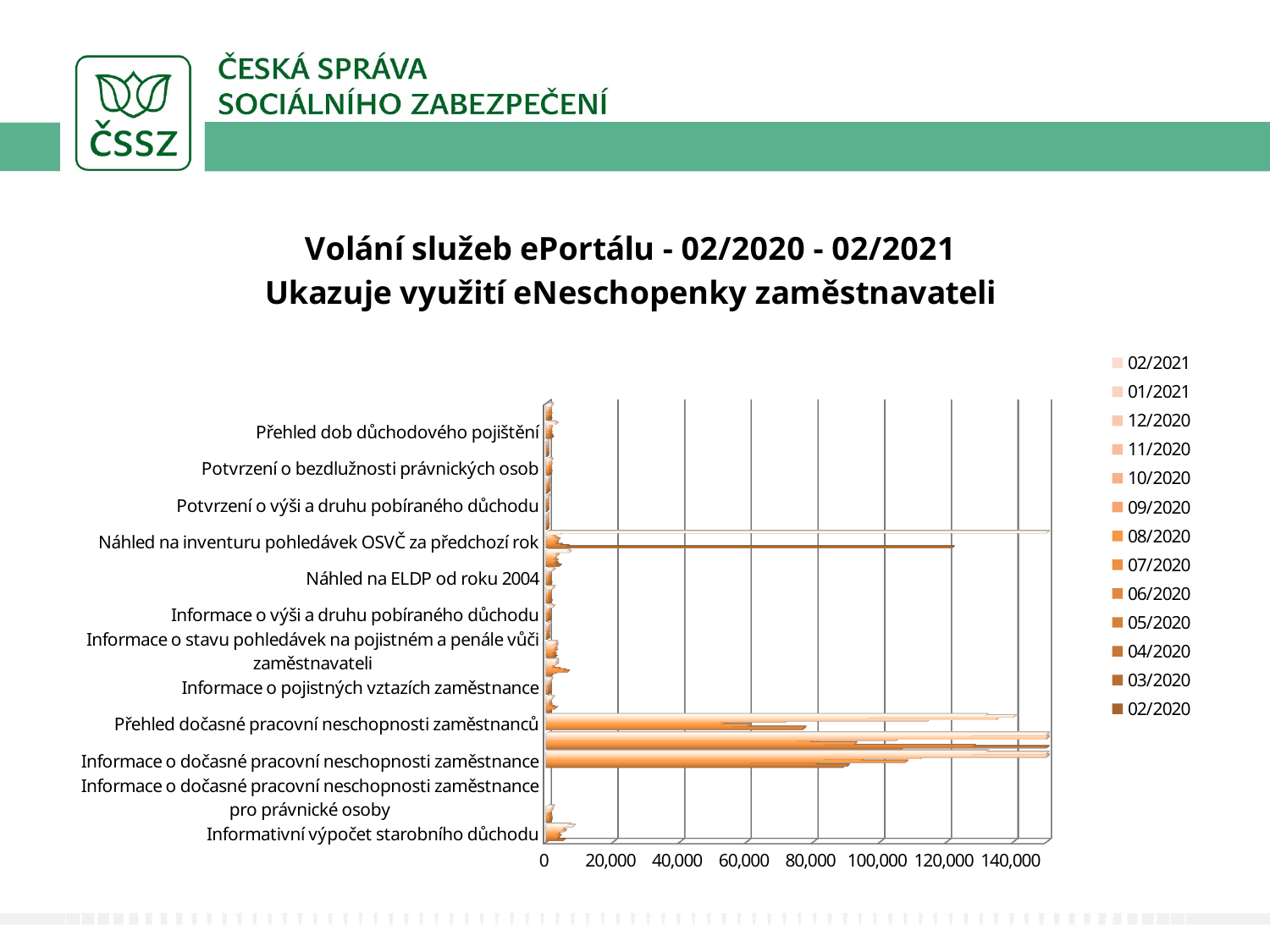
Is the value for 02/2020 for 'Náhled na inventuru pohledávek OSVČ za předchozí rok' greater or less than 100,000? greater Which month is listed first in the legend? 02/2021 What is the title of the chart? Volání služeb ePortálu - 02/2020 - 02/2021 Ukazuje využití eNeschopenky zaměstnavateli Is the largest value for 'Přehled dočasné pracovní neschopnosti zaměstnanců' greater or less than 120,000? greater Are the values for 'Potvrzení o výši a druhu pobíraného důchodu' greater or less than 20,000? less What kind of chart is shown on the slide? bar chart Which category has longer bars: 'Informace o dočasné pracovní neschopnosti zaměstnance' or 'Informace o dočasné pracovní neschopnosti zaměstnance pro právnické osoby'? Informace o dočasné pracovní neschopnosti zaměstnance How many series does the legend list? 13 What is the highest tick label shown on the horizontal axis? 140,000